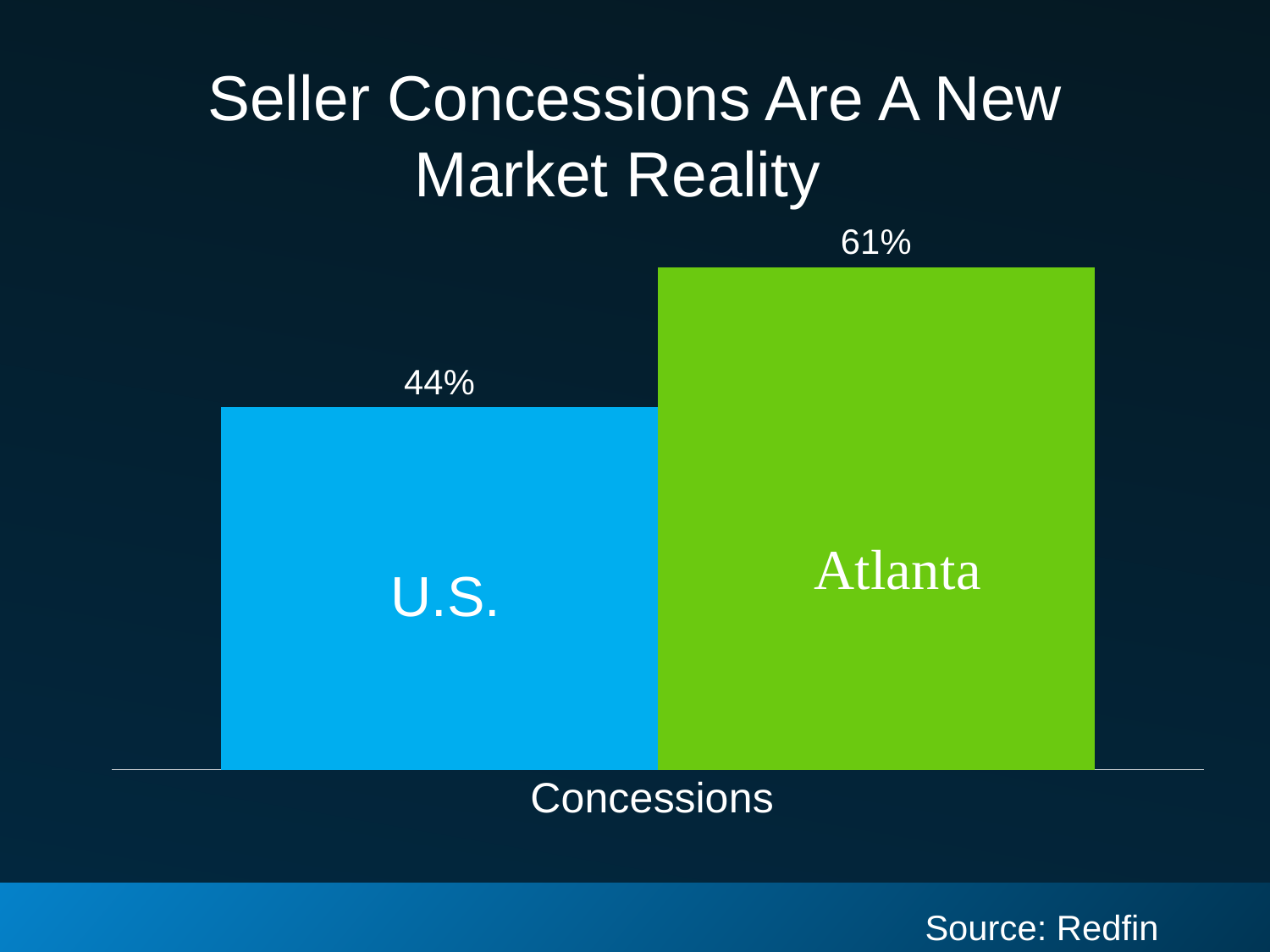
What is the title of the slide? Seller Concessions Are A New Market Reality What kind of chart is shown on the slide? Bar chart What is the value for U.S.? 44% What is the difference between the Atlanta value and the U.S. value? 17% What is the value for Atlanta? 61% Which bar is highest? Atlanta What is the label on the x axis of the chart? Concessions Which is larger, the value for U.S. or the value for Atlanta? Atlanta What is the source cited for the chart? Redfin How many bars are shown in the chart? 2 Which bar is lowest? U.S.